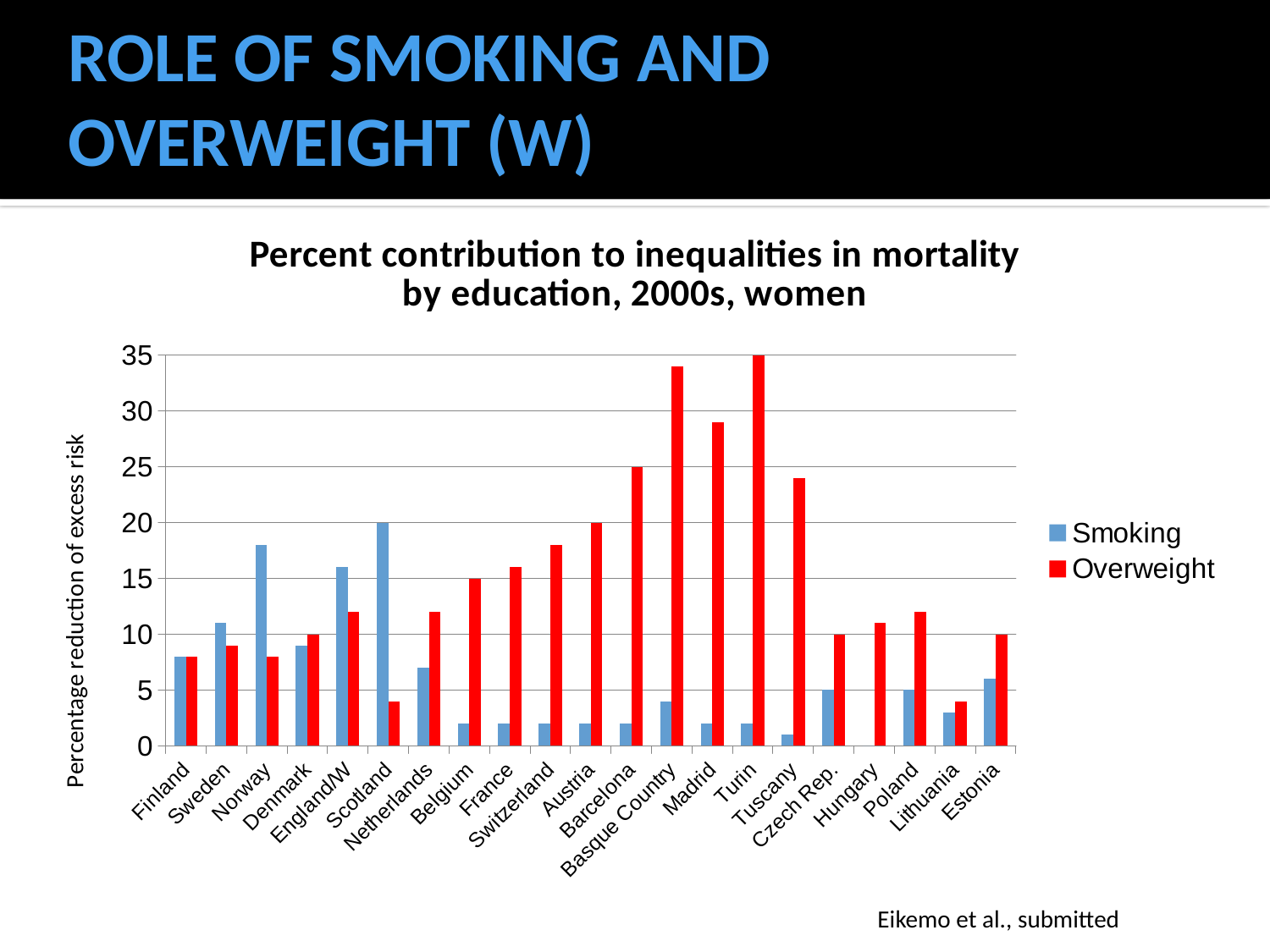
For Scotland, which is larger, the Smoking value or the Overweight value? Smoking What is the label on the vertical axis? Percentage reduction of excess risk Which country or region has the highest Smoking value? Scotland Is the Smoking value for Norway greater or less than 15? greater How many series does the legend list? 2 How many countries or regions are shown on the x axis? 21 What is the Overweight value for Barcelona? 25 What kind of chart is shown on the slide? Bar chart What is the Smoking value for Scotland? 20 Is the Overweight value for Basque Country greater or less than 30? greater